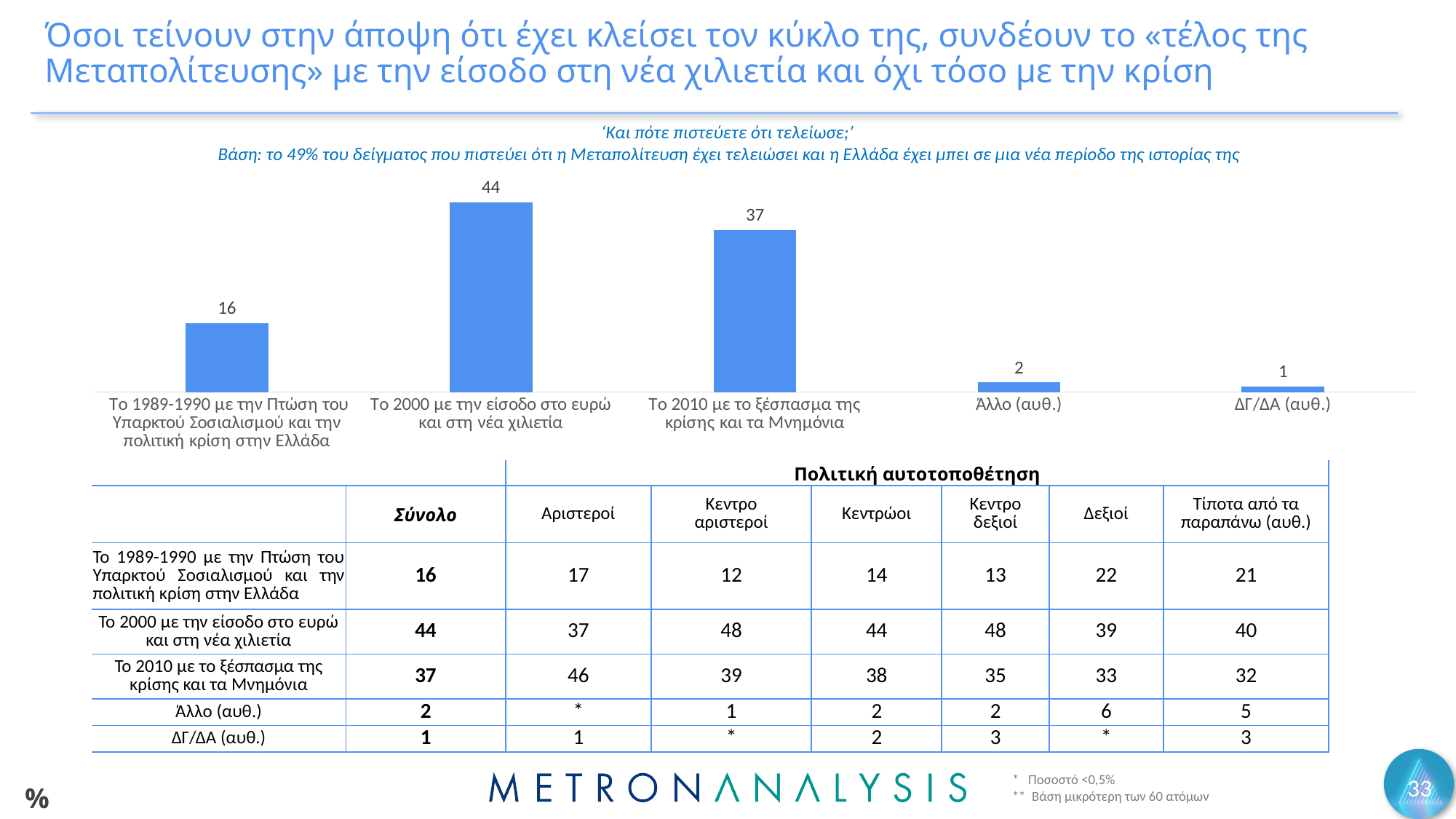
Which category has the lowest value? ΔΓ/ΔΑ (αυθ.) What is the difference between the values for 'Το 2000 με την είσοδο στο ευρώ και στη νέα χιλιετία' and 'Το 1989-1990 με την Πτώση του Υπαρκτού Σοσιαλισμού και την πολιτική κρίση στην Ελλάδα'? 28 What is the value for 'Το 1989-1990 με την Πτώση του Υπαρκτού Σοσιαλισμού και την πολιτική κρίση στην Ελλάδα'? 16 Which category has the highest value? Το 2000 με την είσοδο στο ευρώ και στη νέα χιλιετία Which is larger: the value for 'Το 1989-1990 με την Πτώση του Υπαρκτού Σοσιαλισμού και την πολιτική κρίση στην Ελλάδα' or the value for 'Το 2010 με το ξέσπασμα της κρίσης και τα Μνημόνια'? Το 2010 με το ξέσπασμα της κρίσης και τα Μνημόνια What kind of chart is shown on the slide? bar chart What is the difference between the values for 'Το 2000 με την είσοδο στο ευρώ και στη νέα χιλιετία' and 'Το 2010 με το ξέσπασμα της κρίσης και τα Μνημόνια'? 7 What is the value for 'Το 2010 με το ξέσπασμα της κρίσης και τα Μνημόνια'? 37 What is the value for 'Το 2000 με την είσοδο στο ευρώ και στη νέα χιλιετία'? 44 What is the value for 'ΔΓ/ΔΑ (αυθ.)'? 1 How many categories are shown in the bar chart? 5 What is the value for 'Άλλο (αυθ.)'? 2